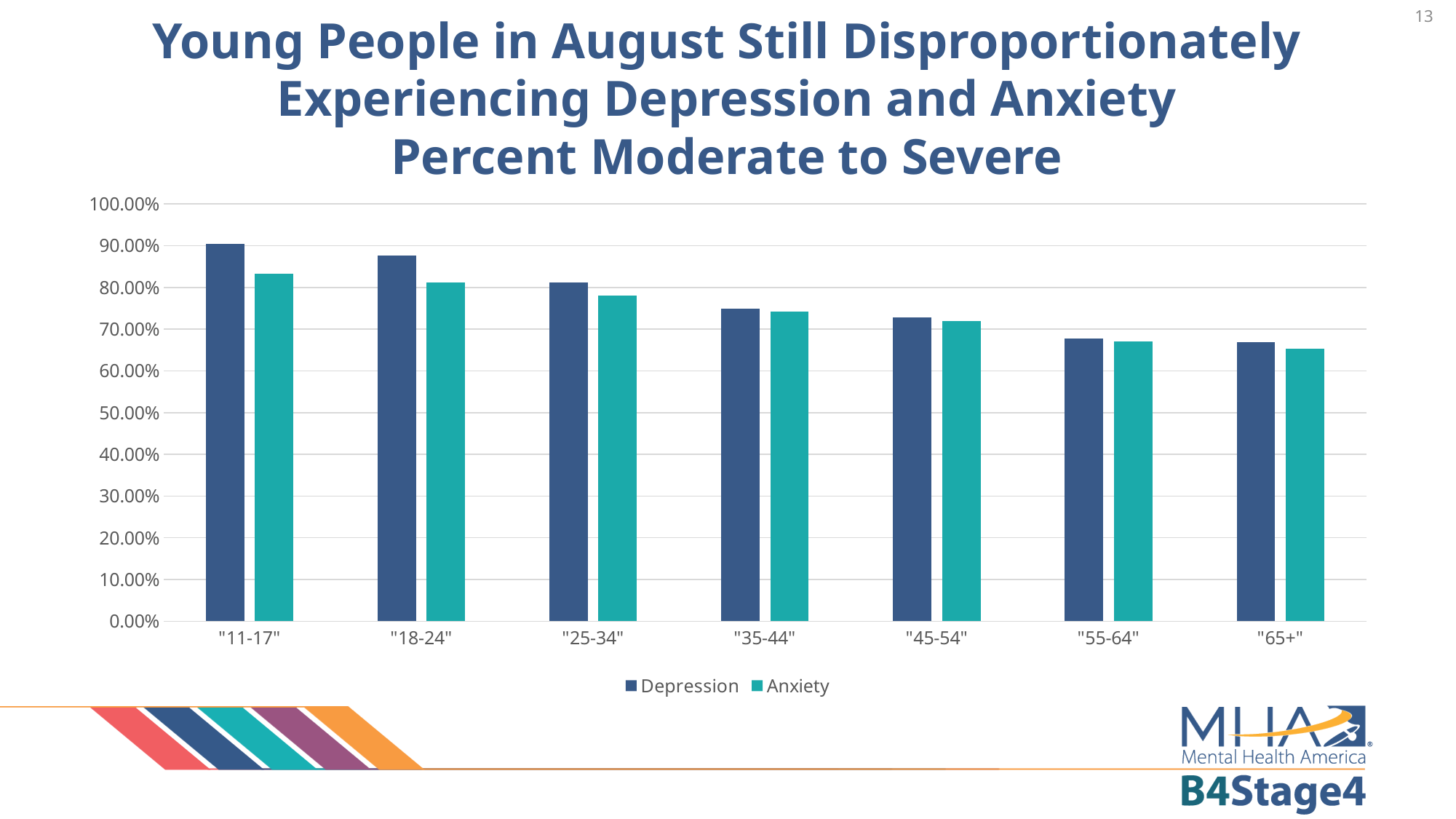
Is the Anxiety value for "65+" greater or less than 70.00%? less For the "18-24" age group, which is larger, Depression or Anxiety? Depression Is the Depression value for "11-17" greater or less than 80.00%? greater Is the Depression value for "55-64" greater or less than 70.00%? less Which age group has the highest Anxiety value? "11-17" How many series does the legend list? 2 What colour are the Anxiety bars? Teal Which age group has the highest Depression value? "11-17" What kind of chart is shown on the slide? Bar chart Which age group has the lowest Anxiety value? "65+" How many age groups are shown on the x axis? 7 Do the Depression values rise or fall as age increases along the x axis? Fall